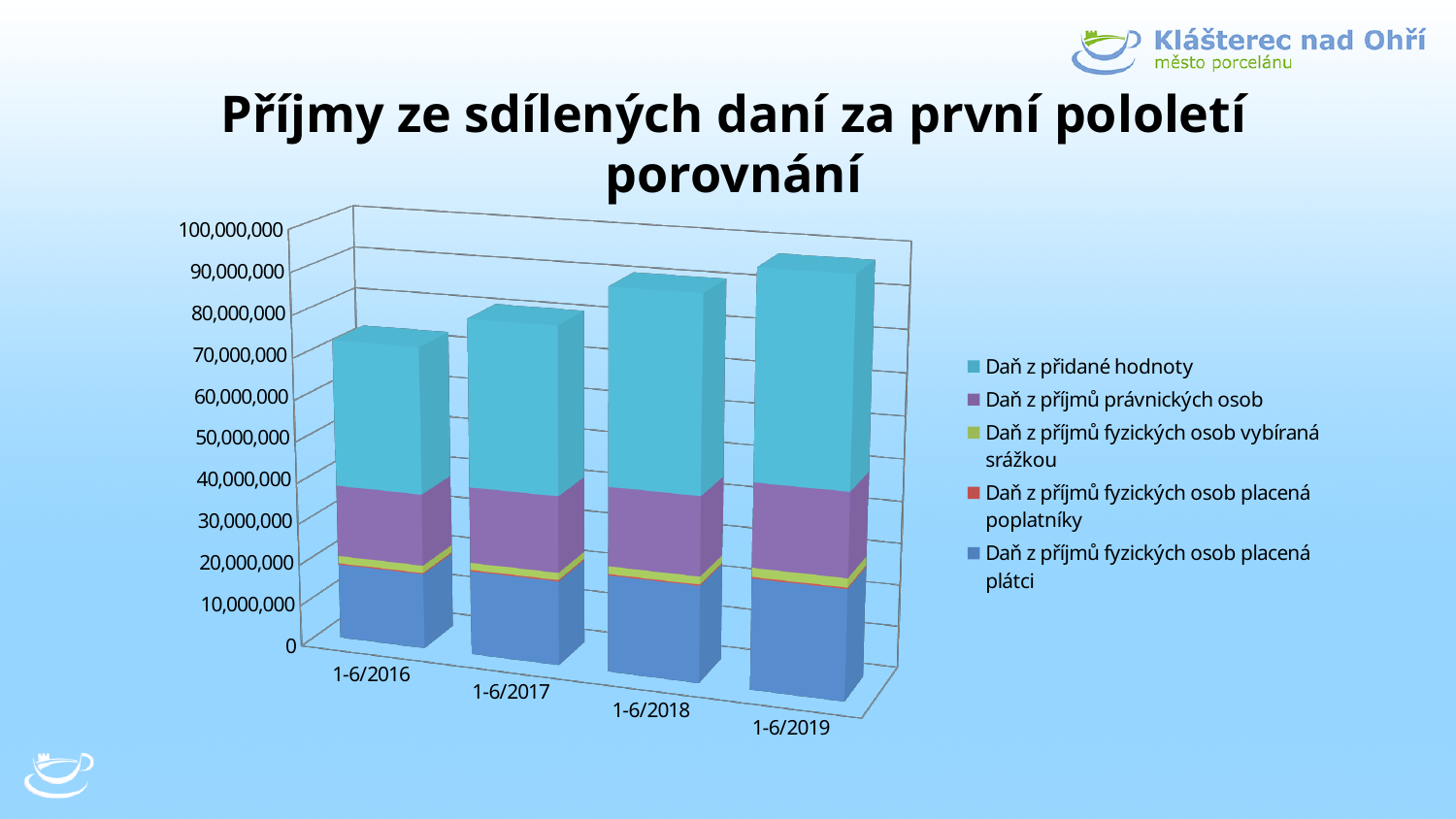
Is the total value for 1-6/2018 greater or less than 70,000,000? greater Is the total value for 1-6/2019 greater or less than 80,000,000? greater What is the title of the chart on the slide? Příjmy ze sdílených daní za první pololetí porovnání Which total is larger, 1-6/2017 or 1-6/2016? 1-6/2017 How many series does the chart's legend list? 5 What kind of chart is shown on the slide? Stacked bar chart Which period has the highest total stacked bar? 1-6/2019 Do the total bar heights rise or fall from 1-6/2016 to 1-6/2019? Rise Which series forms the top (light blue) segment of each stacked bar? Daň z přidané hodnoty Is the total value for 1-6/2016 greater or less than 60,000,000? greater Which period has the lowest total stacked bar? 1-6/2016 How many periods (categories) are shown on the x axis of the chart? 4